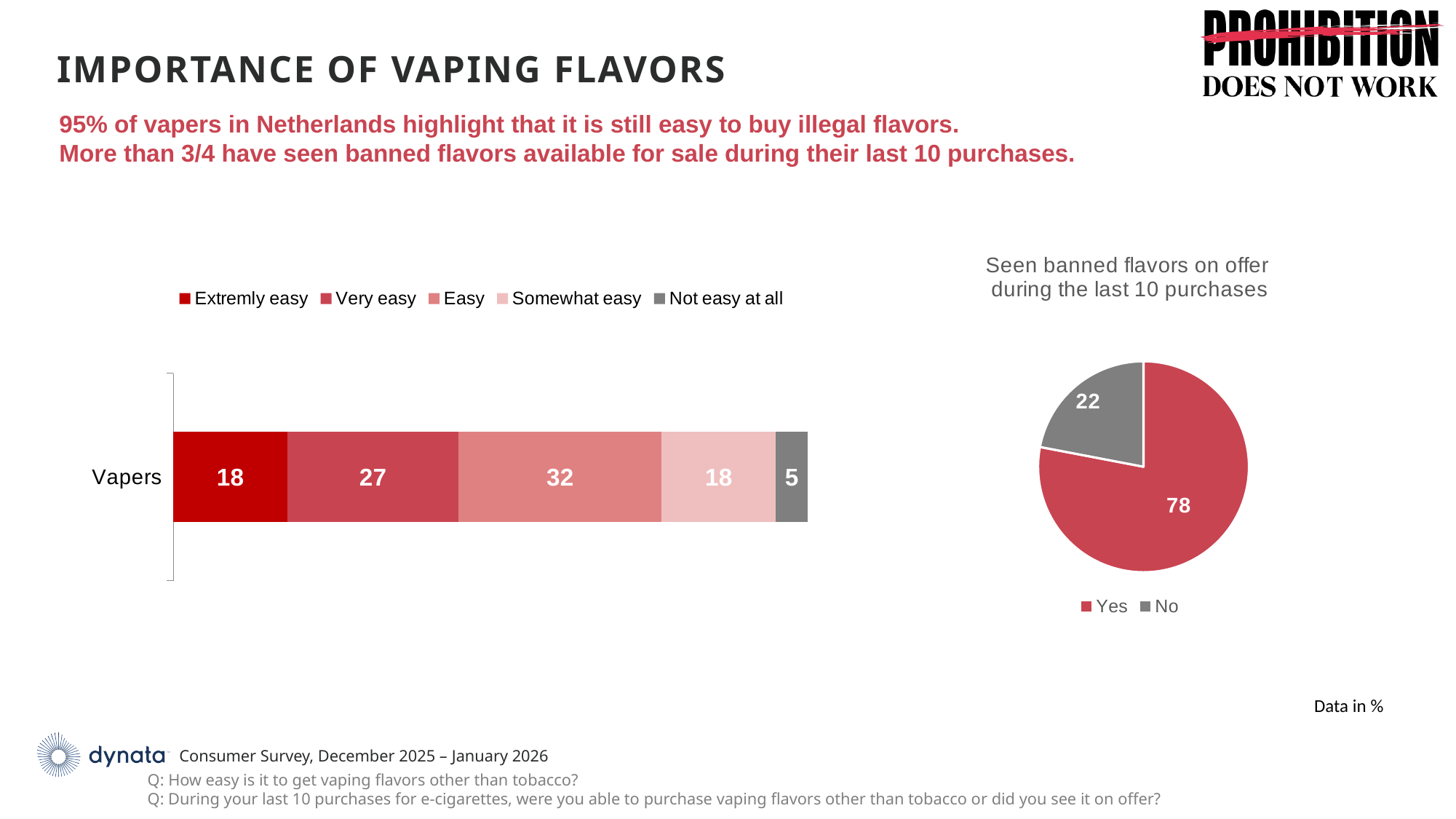
In the stacked bar chart on the left, which series has the smallest value for Vapers? Not easy at all In the stacked bar chart on the left, how many series does the legend list? 5 In the stacked bar chart on the left, what is the total of the Vapers bar? 100 What kind of chart is the chart on the right of the slide? Pie chart In the pie chart titled "Seen banned flavors on offer during the last 10 purchases", which slice is larger, Yes or No? Yes In the pie chart titled "Seen banned flavors on offer during the last 10 purchases", what is the value for "Yes"? 78 In the pie chart titled "Seen banned flavors on offer during the last 10 purchases", what is the value for "No"? 22 In the stacked bar chart on the left, what is the value for "Extremly easy" for Vapers? 18 In the stacked bar chart on the left, what is the difference between the "Easy" and "Very easy" values for Vapers? 5 In the stacked bar chart on the left, what is the value for "Not easy at all" for Vapers? 5 In the stacked bar chart on the left, what is the value for "Very easy" for Vapers? 27 In the stacked bar chart on the left, which series has the largest value for Vapers? Easy